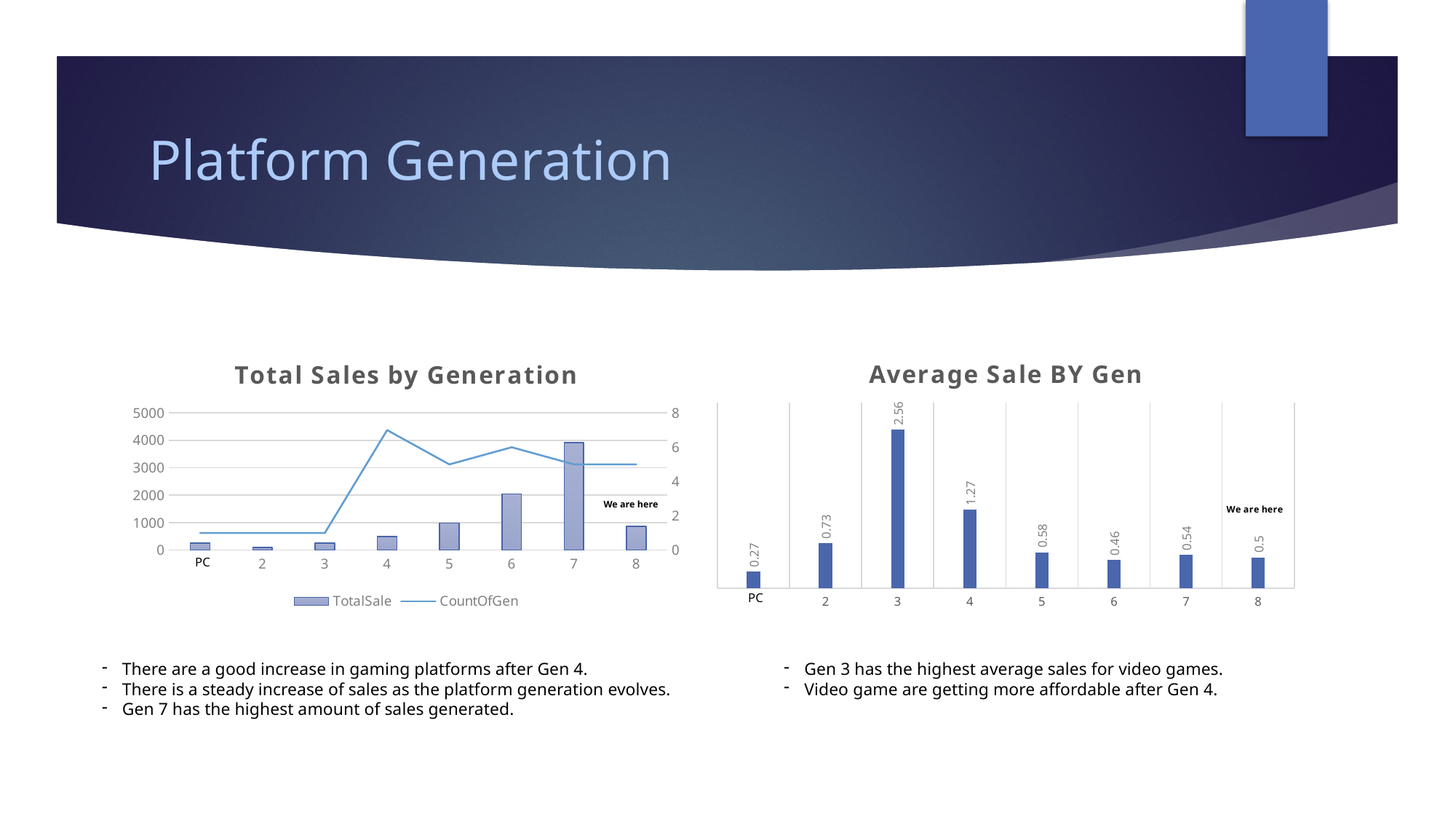
In the 'Average Sale BY Gen' chart, which is larger, the value for generation 2 or generation 5? 2 In the 'Average Sale BY Gen' chart, what is the difference between the values for generation 3 and generation 4? 1.29 In the 'Total Sales by Generation' chart, is the TotalSale value for generation 7 greater or less than 3000? greater In the 'Average Sale BY Gen' chart, which category has the lowest value? PC How many series does the legend of the 'Total Sales by Generation' chart list? 2 In the 'Average Sale BY Gen' chart, what is the value for generation 3? 2.56 In the 'Average Sale BY Gen' chart, which category has the highest value? 3 In the 'Total Sales by Generation' chart, which category has the tallest TotalSale bar? 7 How many categories are shown on the x axis of the 'Average Sale BY Gen' chart? 8 In the 'Total Sales by Generation' chart, is the TotalSale value for generation 4 greater or less than 1000? less In the 'Average Sale BY Gen' chart, what is the value for generation 8? 0.5 In the 'Average Sale BY Gen' chart, what is the value for PC? 0.27